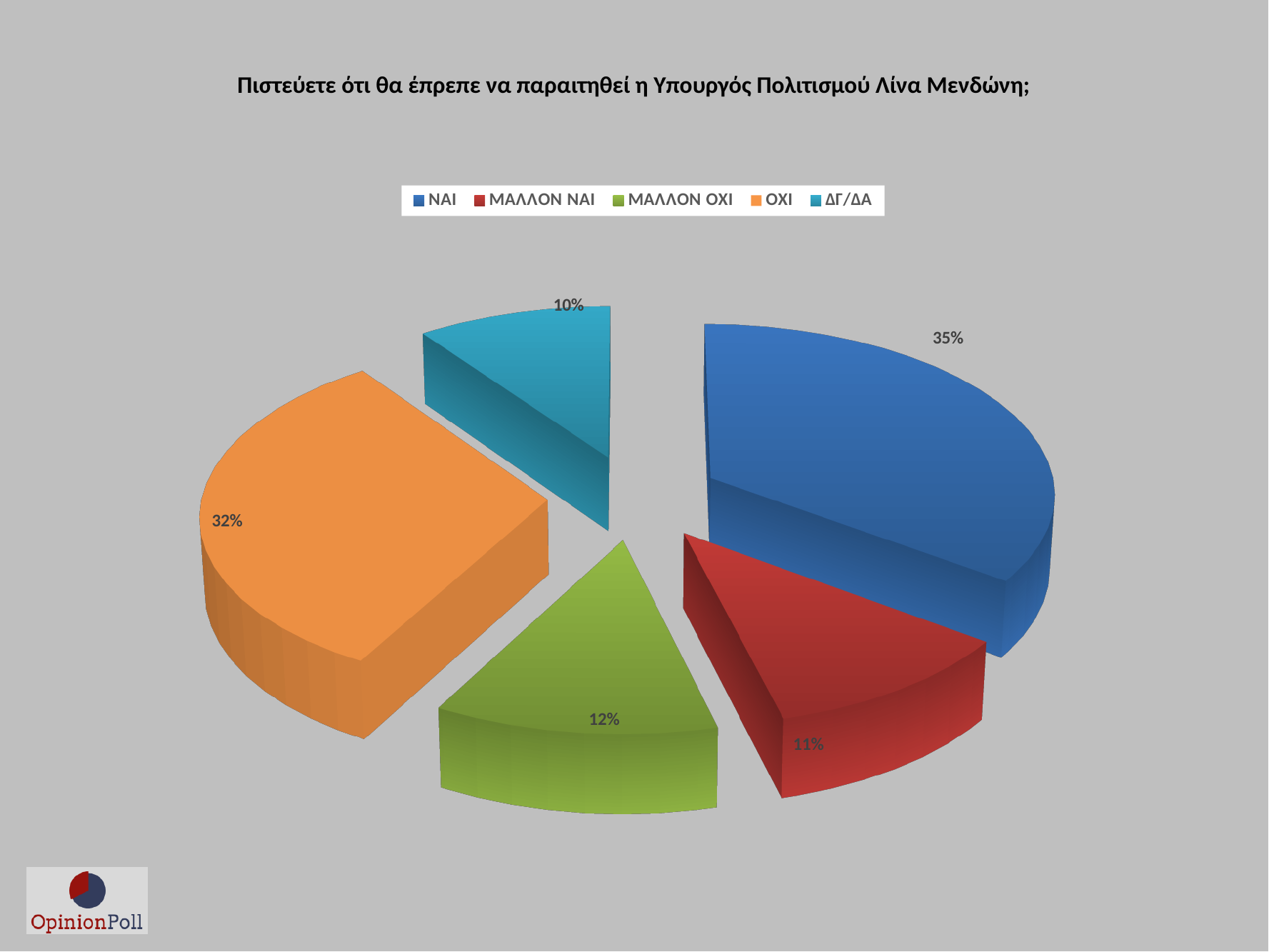
What percentage of respondents answered ΜΑΛΛΟΝ ΝΑΙ? 11% Which response has the largest share of the pie? ΝΑΙ What is the difference in percentage points between ΝΑΙ and ΟΧΙ? 3 percentage points How many categories does the pie chart show? 5 What colour is the slice representing ΟΧΙ? Orange What percentage of respondents answered ΔΓ/ΔΑ? 10% What percentage of respondents answered ΟΧΙ? 32% What kind of chart is shown on the slide? Pie chart What percentage of respondents answered ΝΑΙ? 35% Which is larger, the share for ΟΧΙ or the share for ΜΑΛΛΟΝ ΟΧΙ? ΟΧΙ What percentage of respondents answered ΜΑΛΛΟΝ ΟΧΙ? 12% Which response has the smallest share of the pie? ΔΓ/ΔΑ